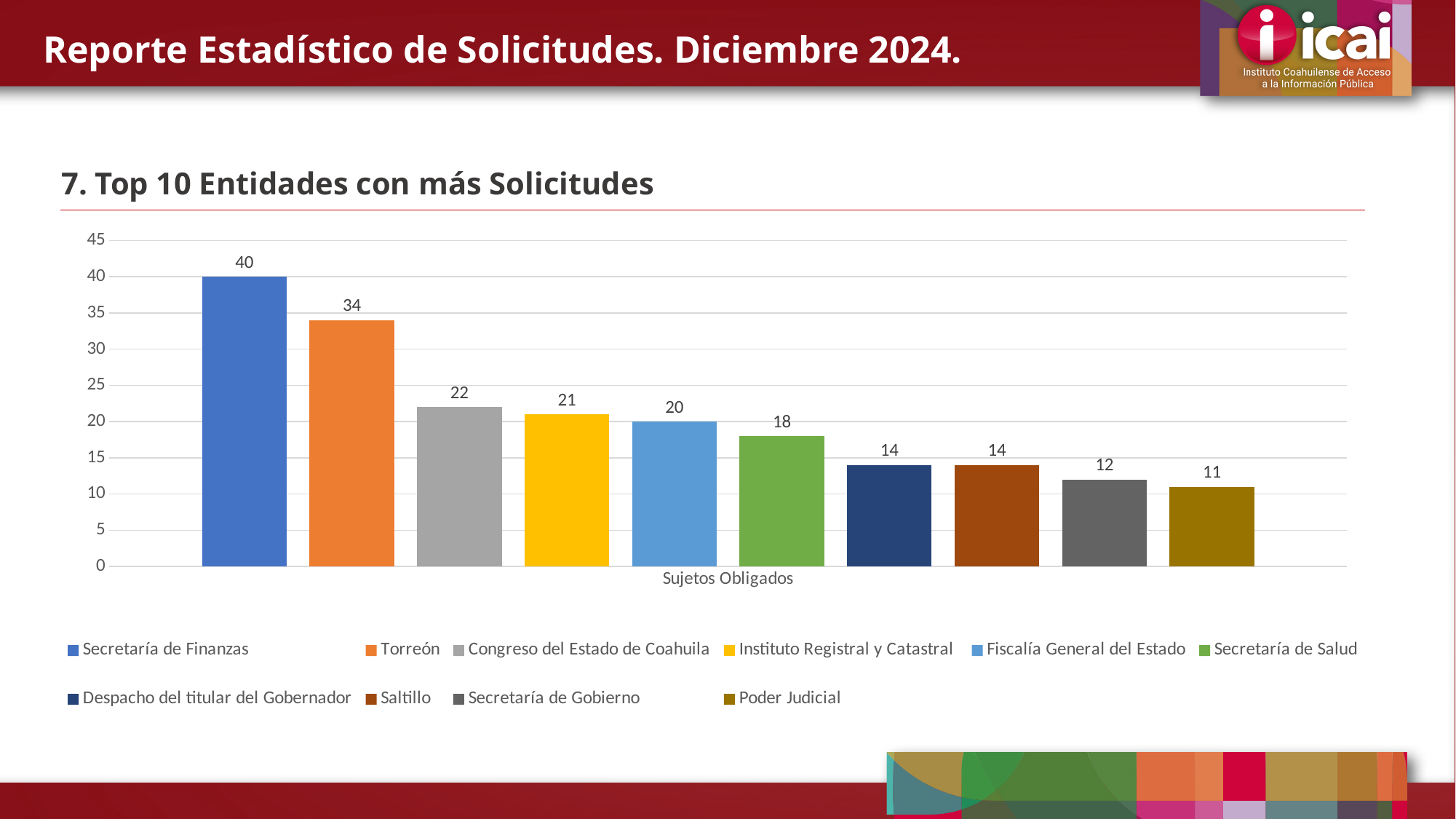
Which entity has the highest number of solicitudes? Secretaría de Finanzas Which is larger, the value for Congreso del Estado de Coahuila or the value for Secretaría de Salud? Congreso del Estado de Coahuila What is the value for Poder Judicial? 11 Which entity has the lowest number of solicitudes? Poder Judicial What is the title of the chart section on the slide? 7. Top 10 Entidades con más Solicitudes What is the value for Fiscalía General del Estado? 20 What kind of chart is shown on the slide? Bar chart How many entries does the legend list? 10 What is the value for Torreón? 34 How many entities are shown in the chart? 10 What is the difference between the values for Secretaría de Finanzas and Torreón? 6 What is the value for Secretaría de Finanzas? 40